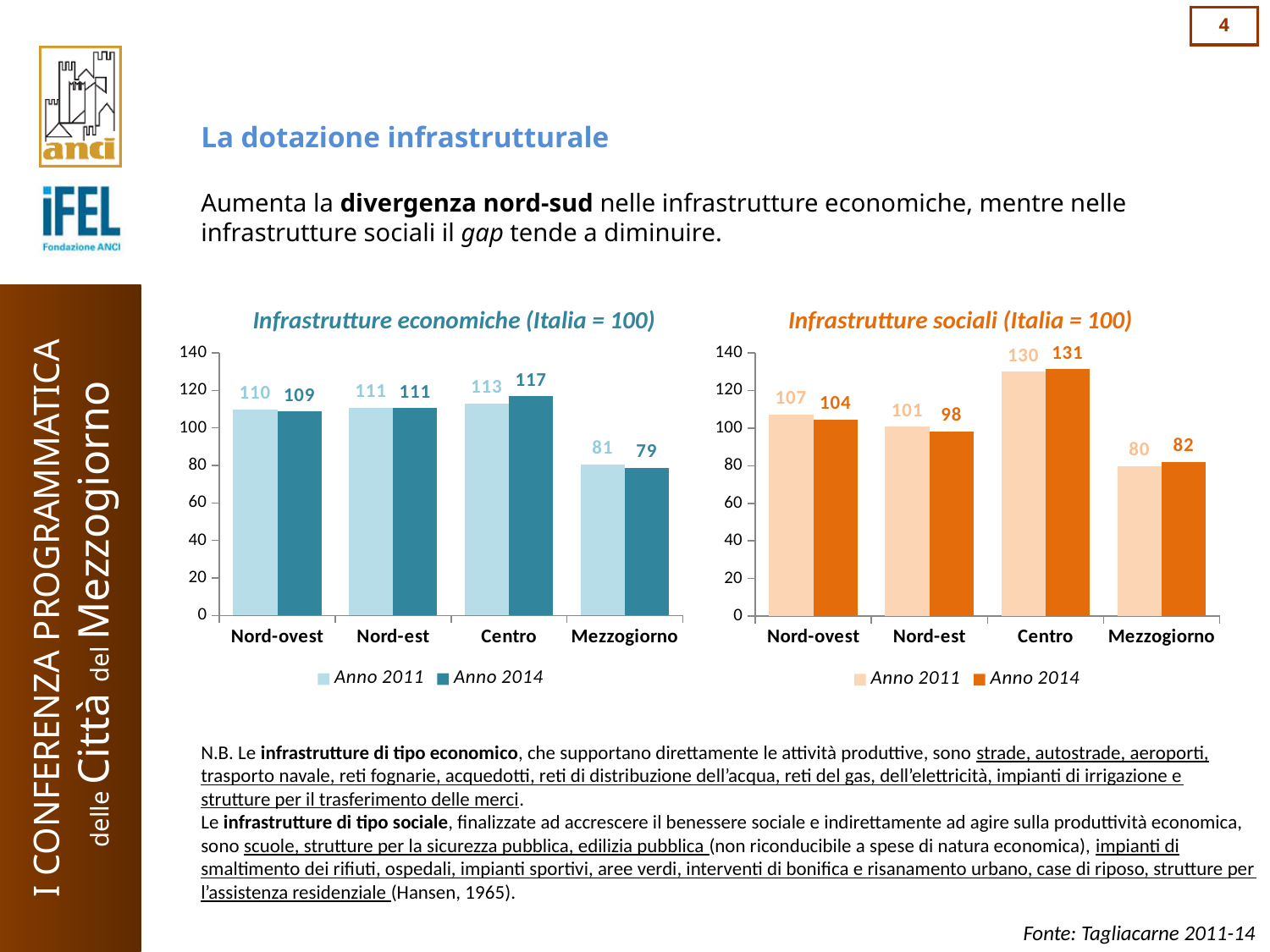
In the 'Infrastrutture economiche (Italia = 100)' chart, what is the difference between the Anno 2014 values for Centro and Mezzogiorno? 38 How many categories are shown on the x axis of the 'Infrastrutture sociali (Italia = 100)' chart? 4 In the 'Infrastrutture sociali (Italia = 100)' chart, which category has the lowest value in Anno 2011? Mezzogiorno In the 'Infrastrutture economiche (Italia = 100)' chart, what is the value for Mezzogiorno in Anno 2014? 79 In the 'Infrastrutture economiche (Italia = 100)' chart, is the value for Mezzogiorno in Anno 2011 greater or less than 100? less How many series does the legend of the 'Infrastrutture economiche (Italia = 100)' chart list? 2 In the 'Infrastrutture sociali (Italia = 100)' chart, what is the value for Nord-ovest in Anno 2011? 107 In the 'Infrastrutture economiche (Italia = 100)' chart, which category has the highest value in Anno 2014? Centro What kind of chart is the 'Infrastrutture sociali (Italia = 100)' chart? bar chart What are the two legend entries of the 'Infrastrutture economiche (Italia = 100)' chart? Anno 2011 and Anno 2014 In the 'Infrastrutture sociali (Italia = 100)' chart, is the Anno 2014 value for Centro larger or smaller than the Anno 2014 value for Nord-ovest? larger In the 'Infrastrutture sociali (Italia = 100)' chart, what is the difference between the Anno 2011 and Anno 2014 values for Nord-est? 3